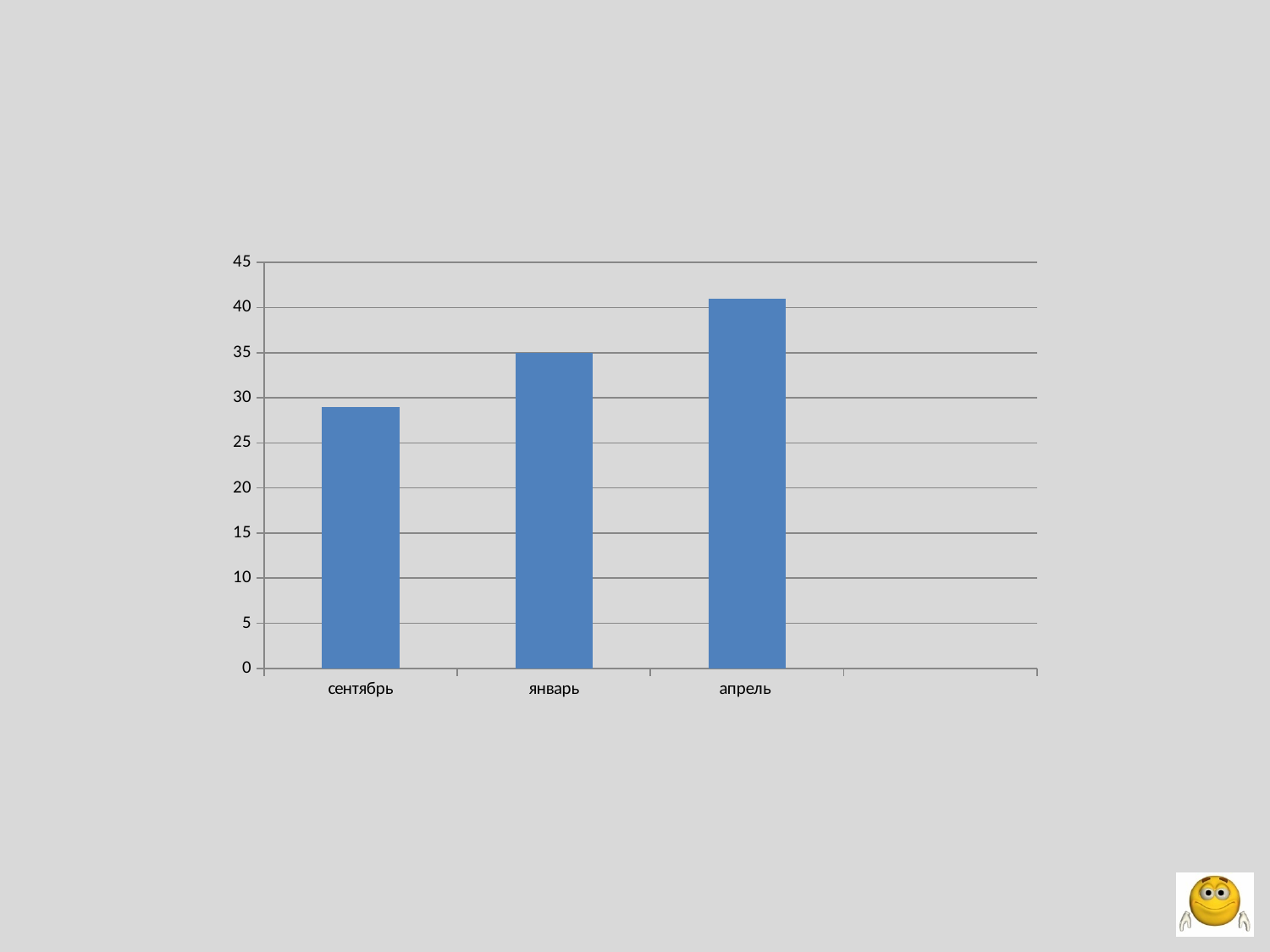
Which is larger, the value for сентябрь or the value for январь? январь Is the value for сентябрь greater or less than 30? less Is the value for сентябрь greater or less than 25? greater Do the values rise or fall from сентябрь to апрель? rise What kind of chart is shown on the slide? bar chart Is the value for апрель greater or less than 40? greater Which category has the lowest bar? сентябрь What is the value for январь? 35 How many categories are shown on the x axis of the chart? 3 What is the highest value shown on the vertical axis? 45 Which is larger, the value for январь or the value for апрель? апрель Which category has the highest bar? апрель